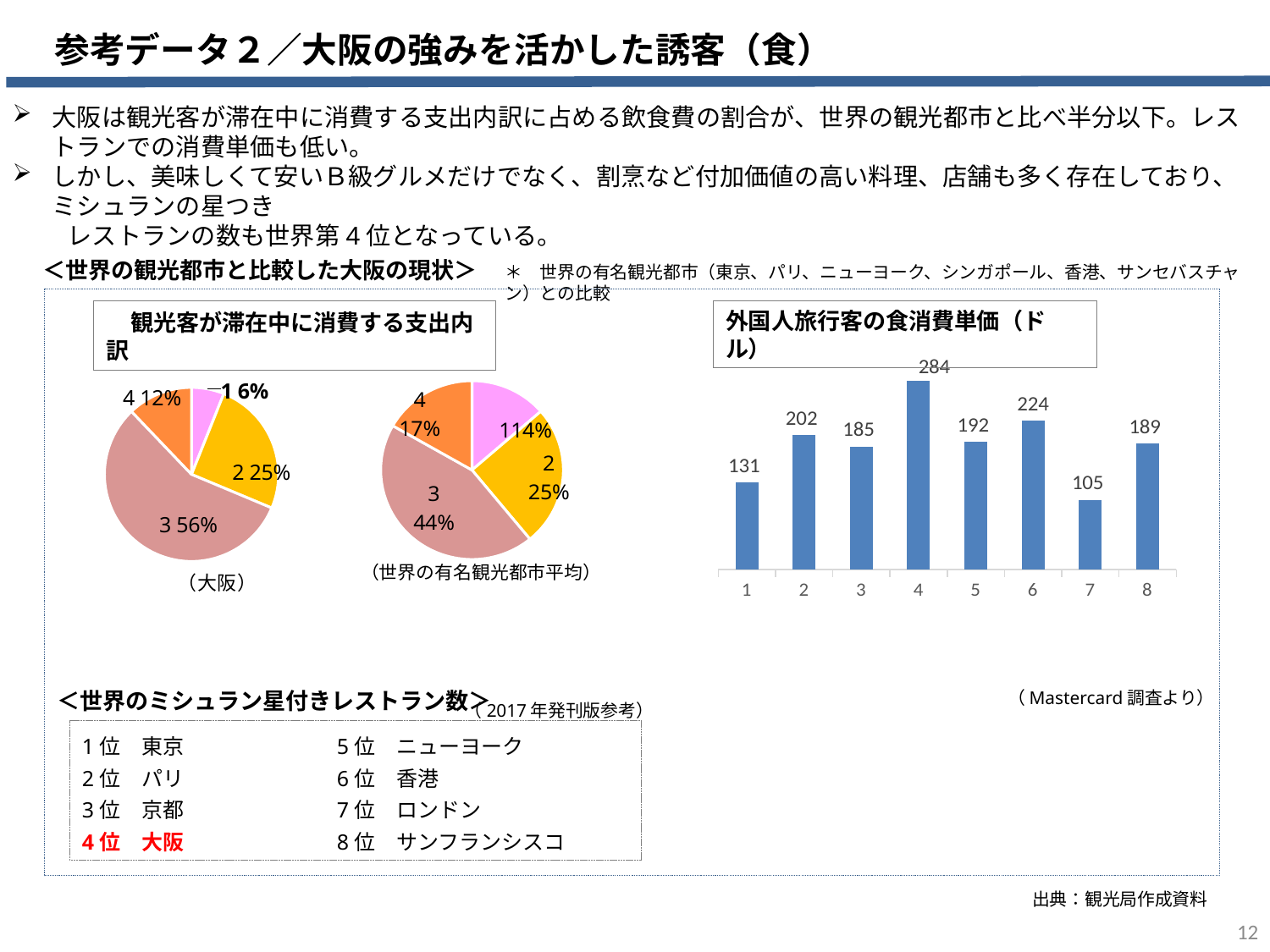
What kind of chart is the chart labelled （世界の有名観光都市平均）? pie chart In the bar chart titled 外国人旅行客の食消費単価（ドル）, which category has the highest value? 4 In the bar chart titled 外国人旅行客の食消費単価（ドル）, which is larger, the value for category 2 or category 6? 6 In the bar chart titled 外国人旅行客の食消費単価（ドル）, what is the value for category 4? 284 In the pie chart labelled （大阪）, which slice is the largest? 3 In the bar chart titled 外国人旅行客の食消費単価（ドル）, what is the difference between the values for category 4 and category 1? 153 How many categories are shown in the bar chart titled 外国人旅行客の食消費単価（ドル）? 8 What kind of chart is the chart titled 外国人旅行客の食消費単価（ドル）? bar chart In the bar chart titled 外国人旅行客の食消費単価（ドル）, what is the value for category 7? 105 In the bar chart titled 外国人旅行客の食消費単価（ドル）, which category has the lowest value? 7 In the pie chart labelled （大阪）, what share does slice 3 have? 56% In the pie chart labelled （世界の有名観光都市平均）, what share does slice 1 have? 14%